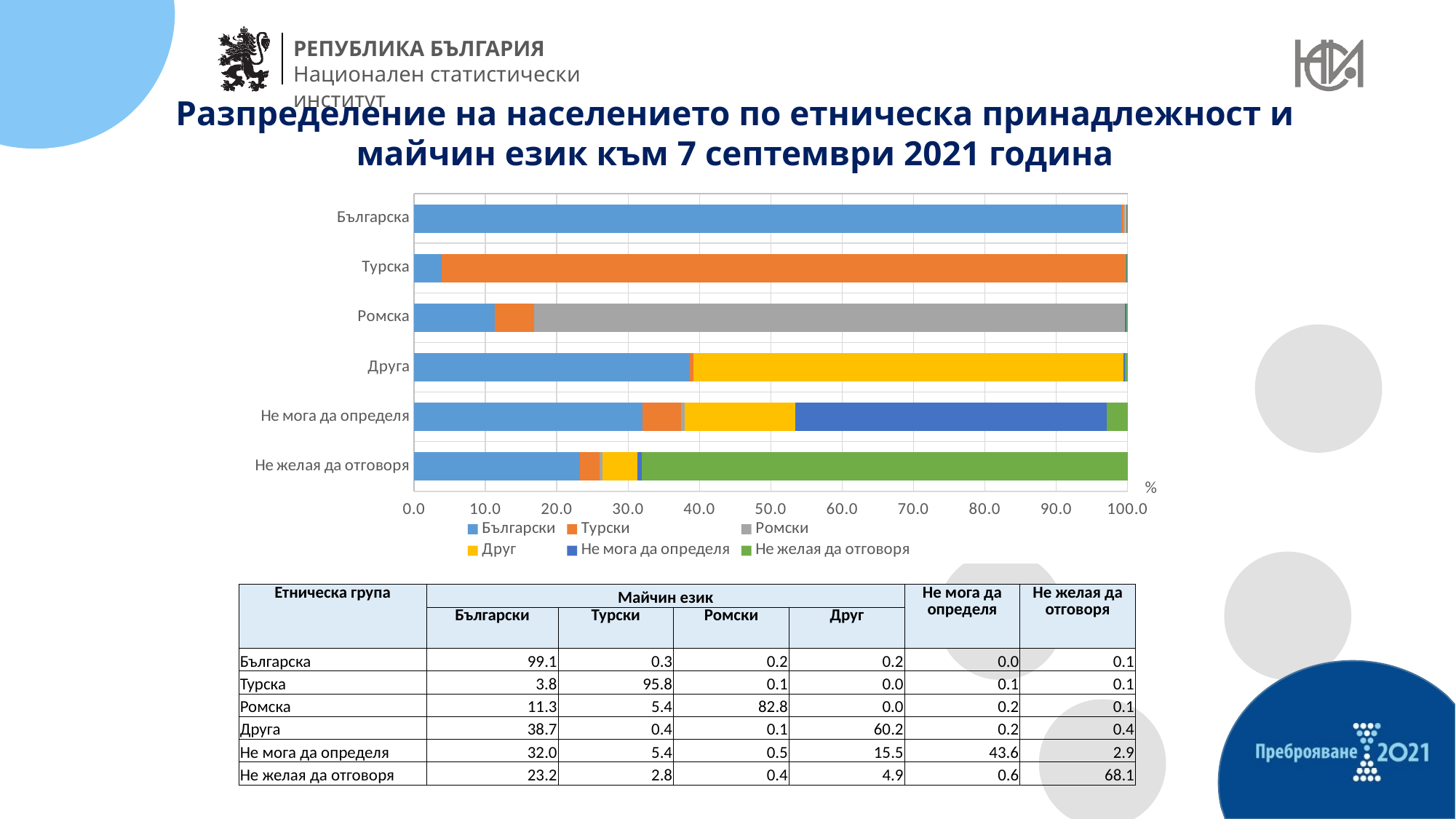
How many series does the chart legend list? 6 What kind of chart is shown on the slide? stacked bar chart What is the share of the Български (Bulgarian) mother tongue for the Българска ethnic group? 99.1 Is the Български share for the Не желая да отговоря group larger or smaller than for the Ромска group? larger What is the share of the Ромски mother tongue for the Ромска ethnic group? 82.8 What is the share of the Турски mother tongue for the Турска ethnic group? 95.8 Which ethnic group has the smallest Български (Bulgarian) mother tongue share? Турска What is the share of the Друг mother tongue for the Друга ethnic group? 60.2 Is the Не желая да отговоря share for the Не желая да отговоря group greater or less than 60.0? greater What is the difference between the Български share for Друга (38.7) and for Не мога да определя (32.0)? 6.7 How many ethnic group categories are plotted on the chart? 6 Which ethnic group has the largest Български (Bulgarian) mother tongue share? Българска